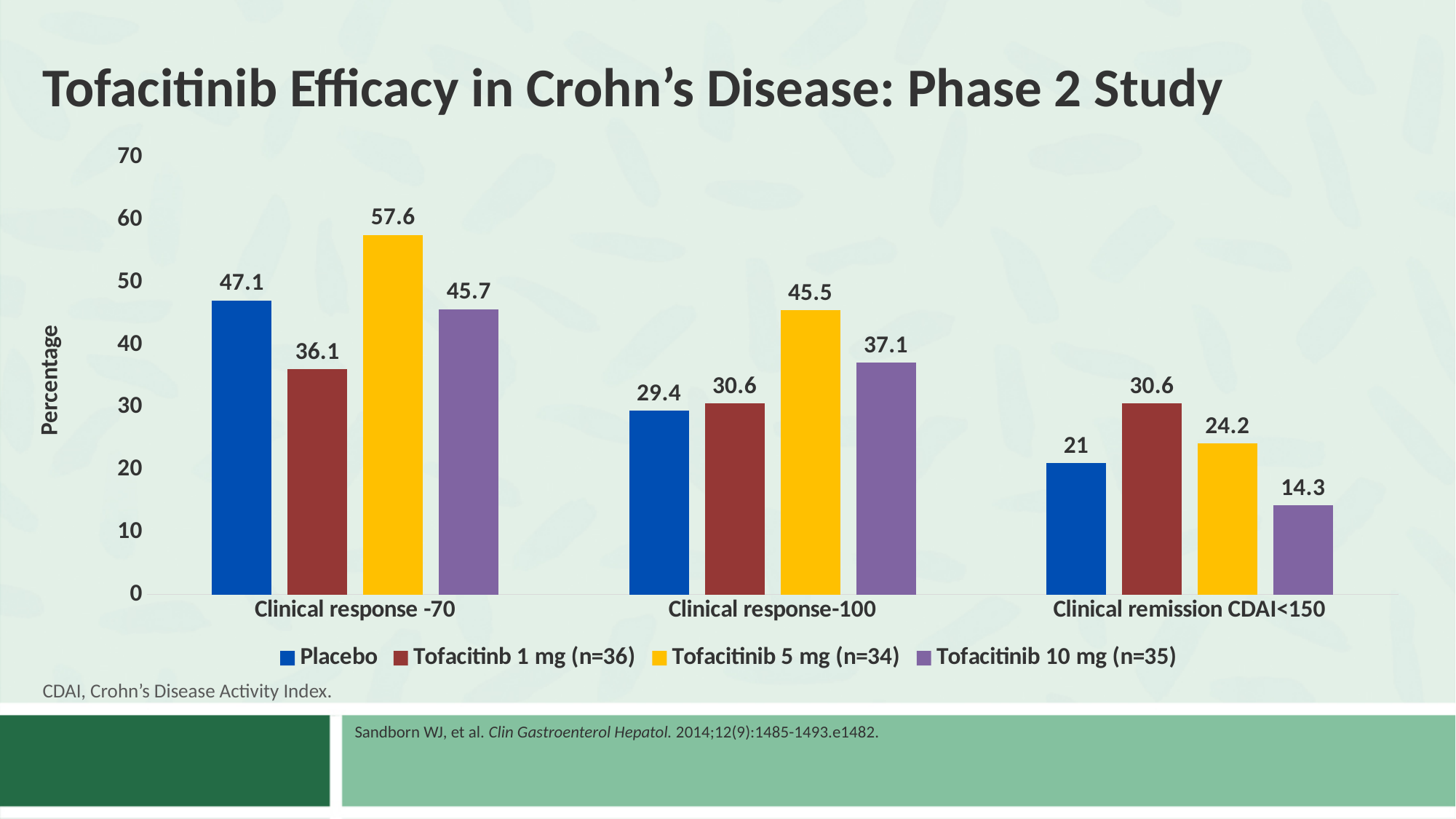
What kind of chart is shown on the slide? Bar chart What is the value for Placebo in the Clinical remission CDAI<150 category? 21 How many categories are shown on the x axis? 3 Which series has the lowest value in the Clinical remission CDAI<150 category? Tofacitinib 10 mg (n=35) How many series does the legend list? 4 What is the value for Tofacitinib 5 mg (n=34) in the Clinical response -70 category? 57.6 Which series has the highest value in the Clinical response -70 category? Tofacitinib 5 mg (n=34) What is the difference between the Tofacitinib 5 mg (n=34) and Placebo values in the Clinical response-100 category? 16.1 What is the label of the y axis? Percentage Is the value for Tofacitinib 10 mg (n=35) in the Clinical response -70 category greater or less than 40? greater Which is larger in the Clinical response -70 category: Placebo or Tofacitinb 1 mg (n=36)? Placebo What is the value for Tofacitinib 10 mg (n=35) in the Clinical response-100 category? 37.1